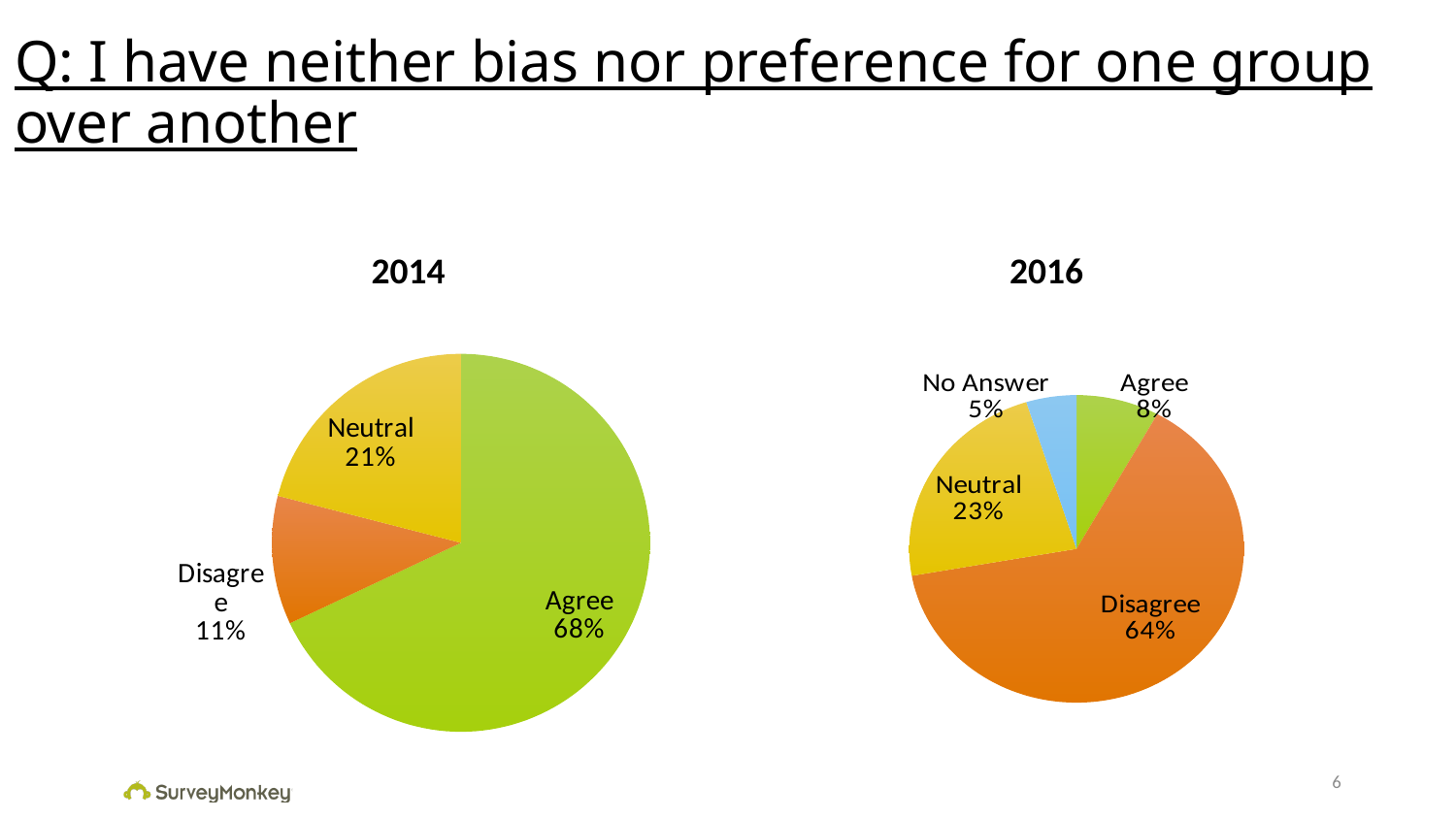
Which is larger: the Agree share in the 2014 chart or the Agree share in the 2016 chart? 2014 In the 2014 pie chart, what share of respondents chose Neutral? 21% In the 2014 pie chart, what share of respondents chose Agree? 68% How many slices does the 2016 pie chart have? 4 What type of chart is used for the 2014 data? Pie chart In the 2016 pie chart, what share of respondents chose No Answer? 5% In the 2016 pie chart, which response has the largest slice? Disagree In the 2014 pie chart, what is the difference between the Agree and Neutral shares? 47% In the 2014 pie chart, which response has the smallest slice? Disagree In the 2016 pie chart, which response has the smallest slice? No Answer In the 2016 pie chart, what share of respondents chose Disagree? 64% In the 2016 pie chart, what is the difference between the Neutral and Agree shares? 15%